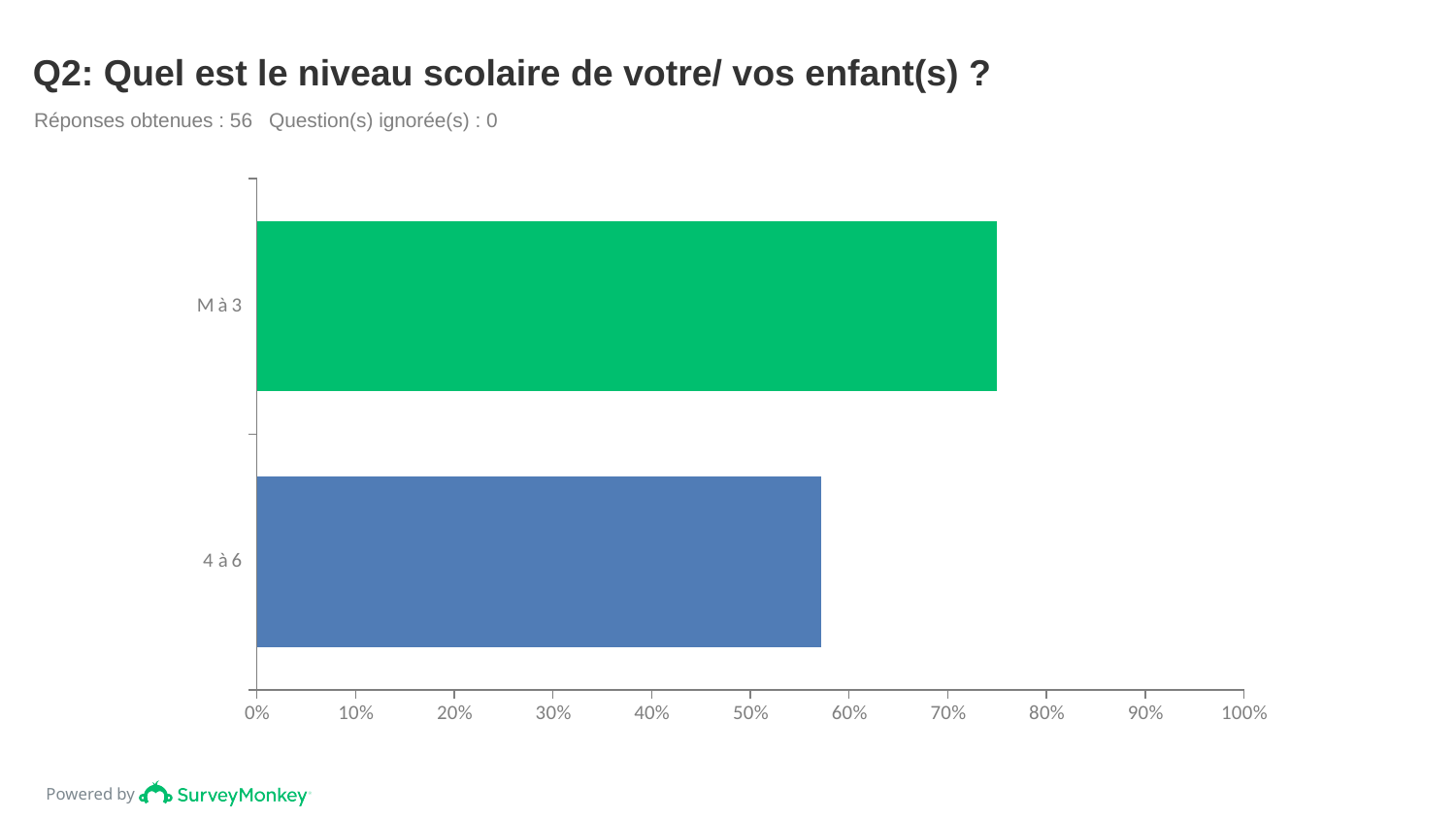
What is the maximum value shown on the x axis? 100% Which is larger, the value for M à 3 or the value for 4 à 6? M à 3 How many categories are plotted in the chart? 2 Is the value for M à 3 greater or less than 70%? greater Is the value for 4 à 6 greater or less than 50%? greater Which category has the lowest value in the chart? 4 à 6 What is the title of the chart on the slide? Q2: Quel est le niveau scolaire de votre/ vos enfant(s) ? What kind of chart is shown on the slide? bar chart Is the value for M à 3 greater or less than 80%? less Which category has the highest value in the chart? M à 3 What colour is the bar for M à 3? green